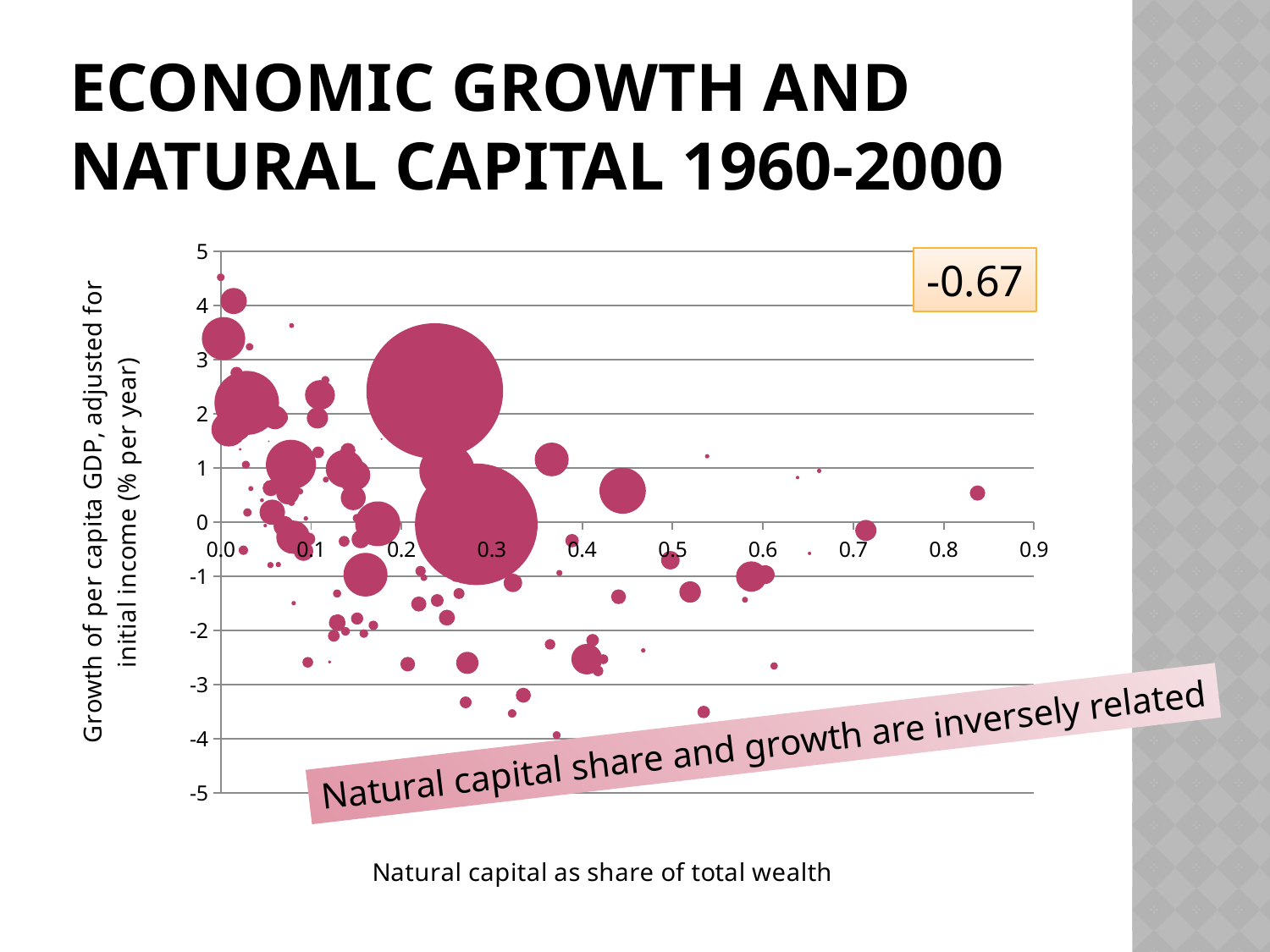
What kind of chart is shown on the slide? Bubble chart What is the title of the chart's x axis? Natural capital as share of total wealth As natural capital share increases along the x axis, does growth of per capita GDP generally rise or fall? Fall What number is shown in the annotation box at the top right of the chart? -0.67